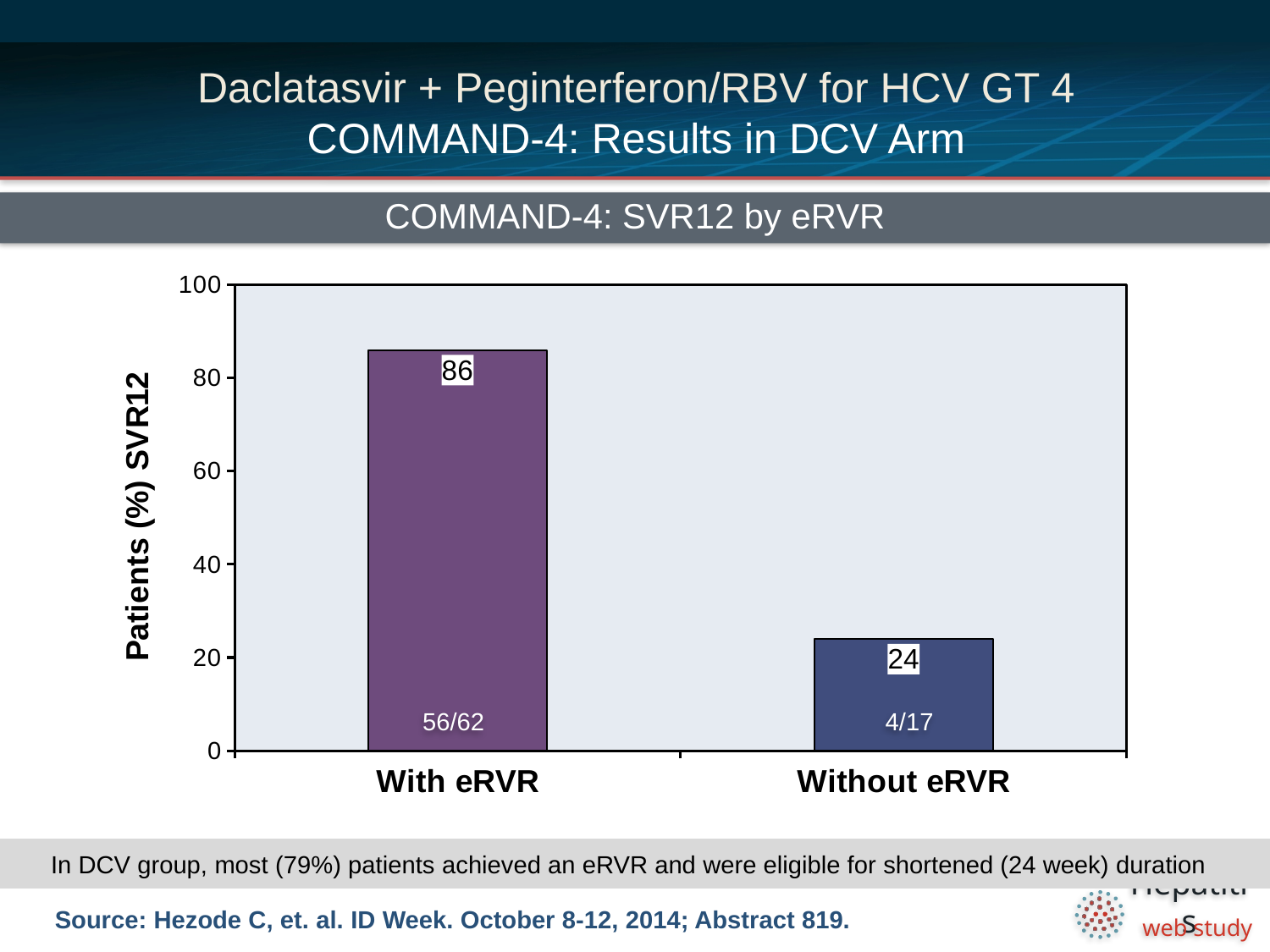
Which category has the lowest SVR12 rate? Without eRVR Is the SVR12 rate higher for patients with eRVR or without eRVR? With eRVR Is the SVR12 rate for patients without eRVR greater or less than 40? less What is the difference in SVR12 rate between patients with eRVR and without eRVR? 62 What is the SVR12 rate (%) for patients with eRVR? 86 Which category has the highest SVR12 rate? With eRVR What fraction of patients is shown inside the 'Without eRVR' bar? 4/17 What kind of chart is shown on the slide? Bar chart What is the title of the chart? COMMAND-4: SVR12 by eRVR What is the SVR12 rate (%) for patients without eRVR? 24 How many categories are shown on the x axis? 2 What fraction of patients is shown inside the 'With eRVR' bar? 56/62